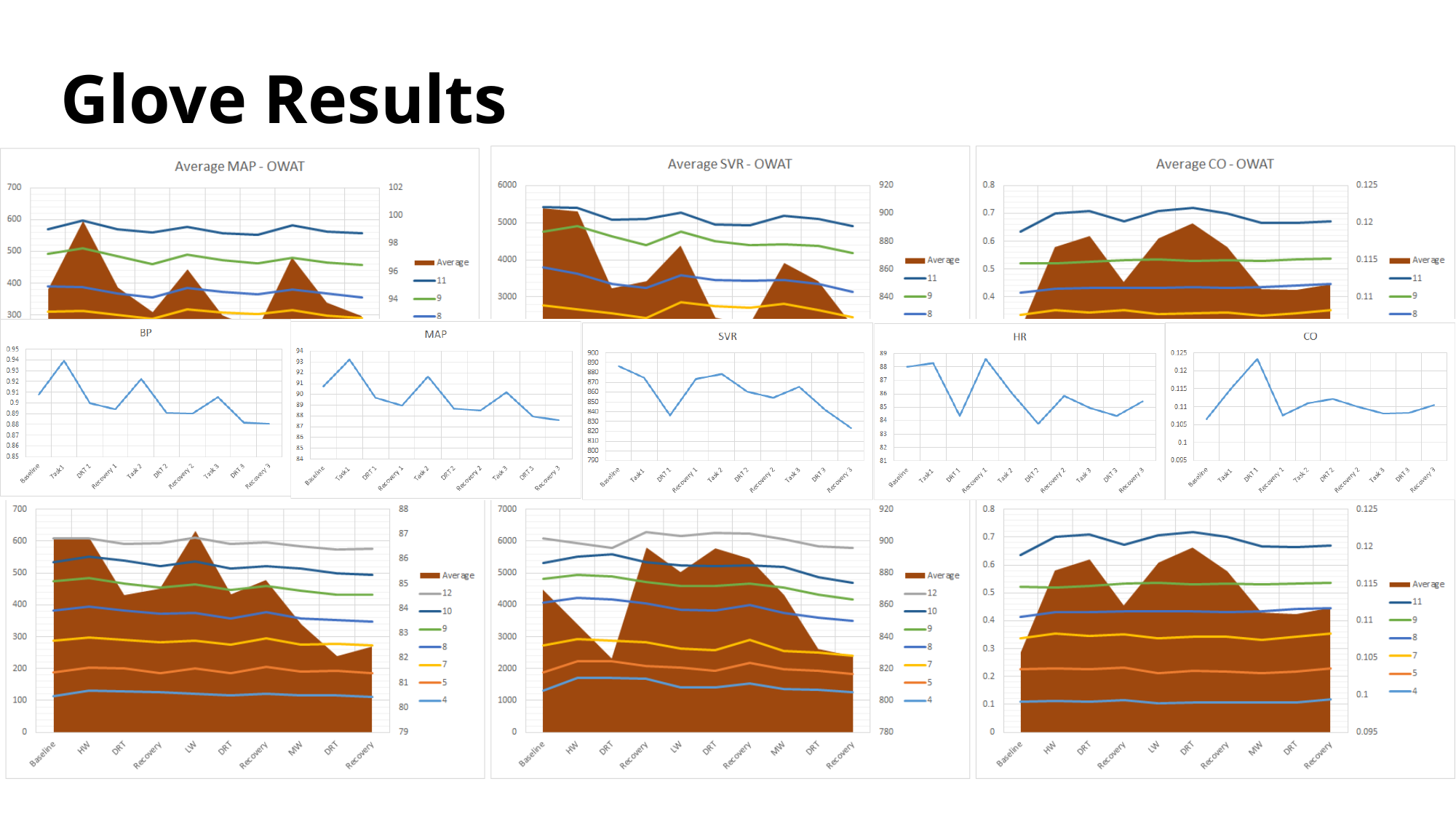
In the middle-row chart titled 'SVR', which category has the lowest value? Recovery 3 In the middle-row chart titled 'BP', which category has the highest value? Task1 In the middle-row chart titled 'MAP', is the value for Recovery 3 greater or less than 89? less In the middle-row chart titled 'CO', which category has the highest value? DRT 1 In the middle-row chart titled 'HR', is the value for Baseline greater or less than 87? greater In the middle-row chart titled 'BP', how many categories are shown on the x axis? 10 What kind of chart is the middle-row chart titled 'HR'? line chart In the middle-row chart titled 'SVR', is the value for DRT 1 greater or less than 850? less In the middle-row chart titled 'MAP', which category has the highest value? Task1 How many series does the legend of the bottom-left chart list? 8 What is the title of the top-left chart? Average MAP - OWAT In the middle-row chart titled 'SVR', do the values rise or fall from Task 3 to Recovery 3? fall